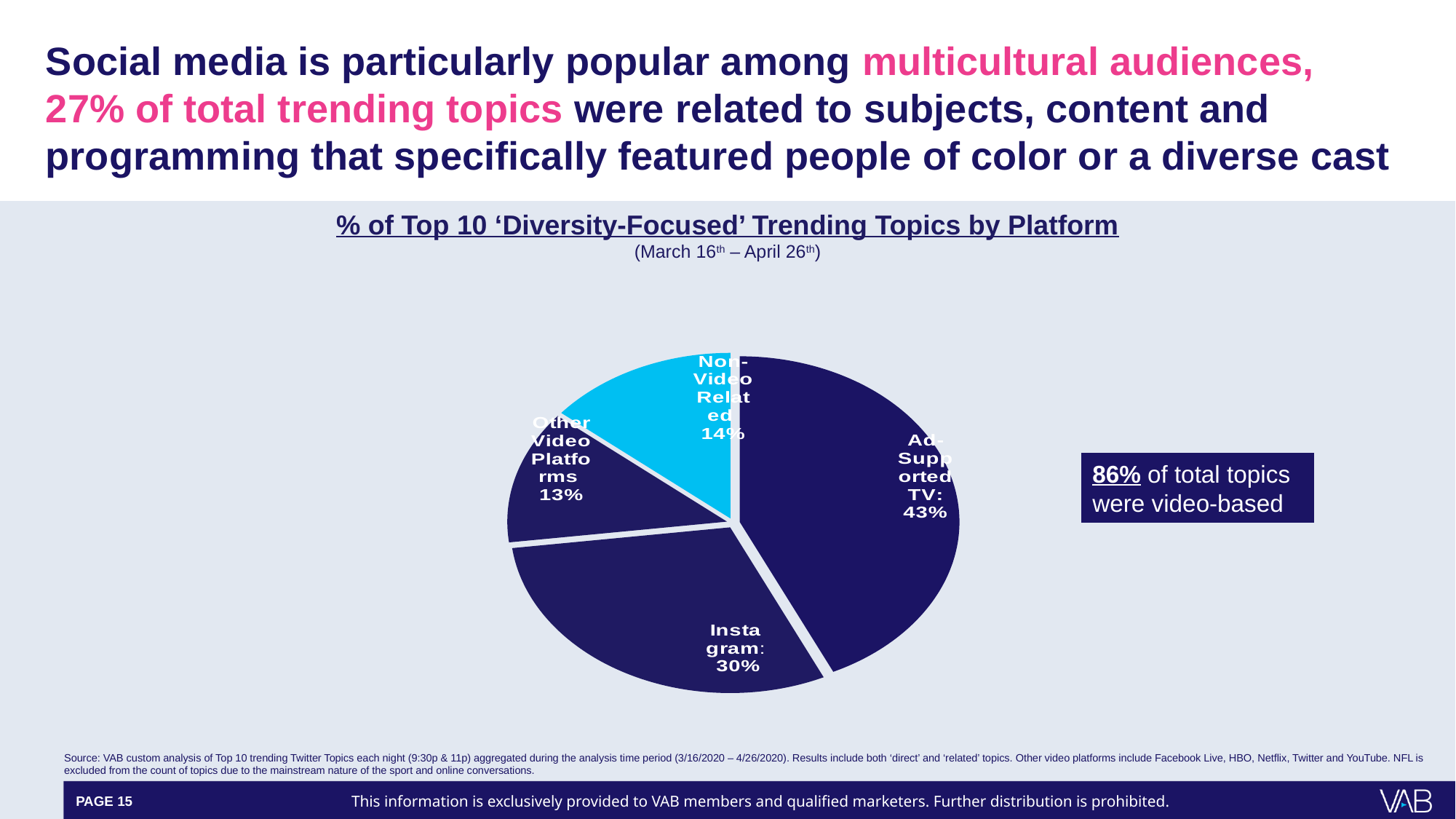
What share of the pie is Non-Video Related? 14% How many slices does the pie chart have? 4 What is the difference in percentage points between Ad-Supported TV and Instagram? 13 Which is larger, the Instagram slice or the Non-Video Related slice? Instagram What share of the pie is Other Video Platforms? 13% Which slice of the pie chart is the smallest? Other Video Platforms What type of chart is shown on the slide? Pie chart Which slice of the pie chart is the largest? Ad-Supported TV Which slice of the pie chart is shown in light blue? Non-Video Related What share of the pie is Ad-Supported TV? 43% What is the title of the chart? % of Top 10 'Diversity-Focused' Trending Topics by Platform